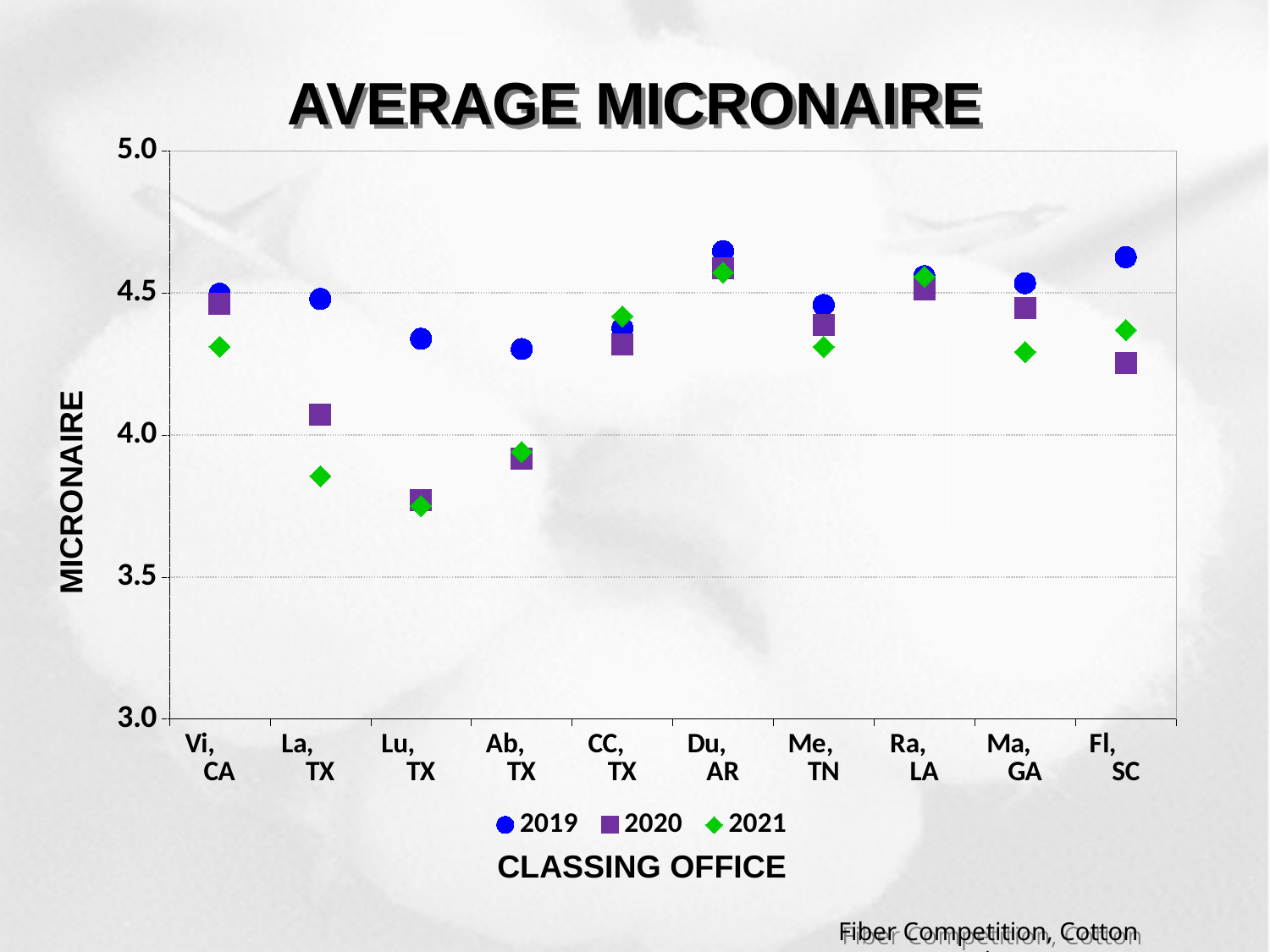
How many series does the legend list? 3 Is the 2020 value for Fl, SC greater or less than 4.5? less Which classing office has the lowest 2020 value? Lu, TX Which classing office has the lowest 2021 value? Lu, TX Which classing office has the highest 2020 value? Du, AR How many classing offices are shown on the x axis? 10 What is the title of the vertical axis? MICRONAIRE Is the 2021 value for La, TX greater or less than 4.0? less What type of chart is shown on the slide? Scatter chart Is the 2019 value for Du, AR greater or less than 4.5? greater For La, TX, which is larger: the 2019 value or the 2021 value? 2019 For Fl, SC, which is larger: the 2020 value or the 2021 value? 2021